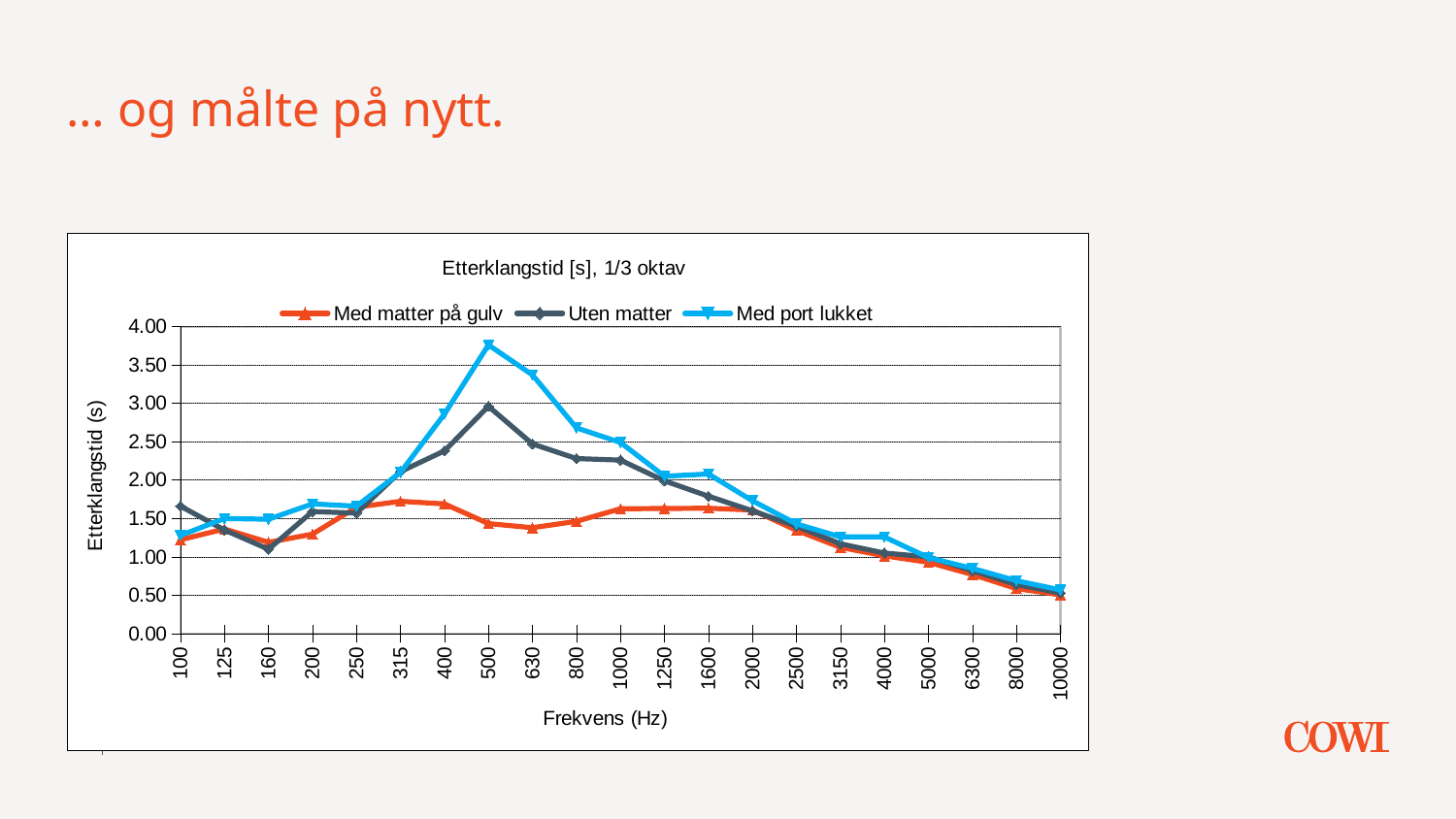
How many series does the chart legend list? 3 What kind of chart is shown on the slide? Line chart Is the value for 'Med port lukket' at 500 Hz greater or less than 3.50? greater Which series reaches the highest value anywhere on the chart? Med port lukket What is the title of the chart? Etterklangstid [s], 1/3 oktav At which frequency does the 'Med port lukket' series reach its highest value? 500 At 160 Hz, which series has the larger value: 'Med port lukket' or 'Uten matter'? Med port lukket At which frequency does the 'Med matter på gulv' series have its lowest value? 10000 What is the label of the x axis? Frekvens (Hz) Does the 'Med port lukket' series rise or fall from 500 Hz to 10000 Hz? Fall How many frequency categories are shown on the x axis? 21 Is the value for 'Med matter på gulv' at 500 Hz greater or less than 2.00? less